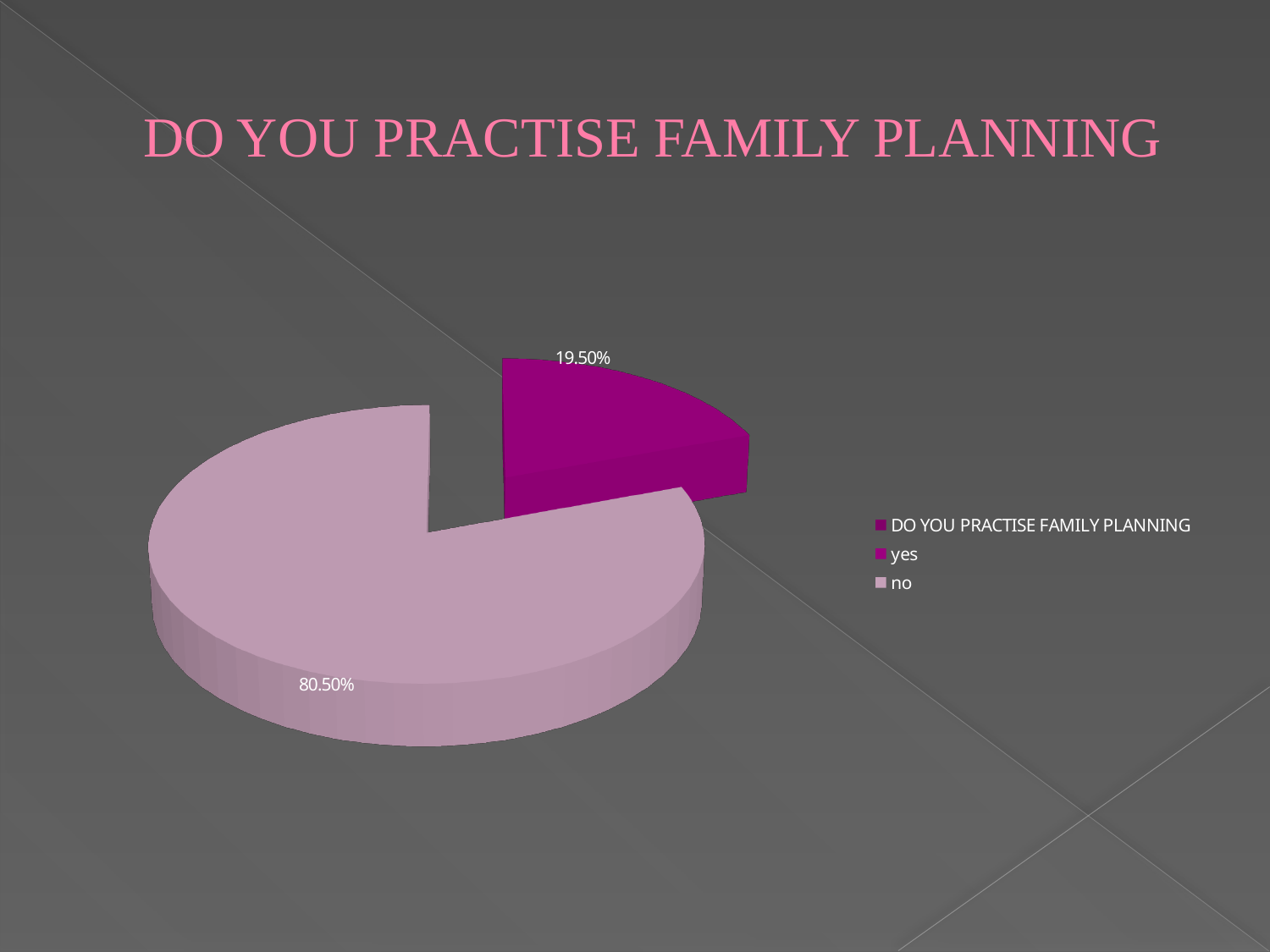
What is the value shown on the smaller slice of the pie? 19.50% What is the title of the chart? DO YOU PRACTISE FAMILY PLANNING What is the value shown on the larger slice of the pie? 80.50% How many entries does the legend list? 3 What is the largest value labelled on the pie chart? 80.50% What kind of chart is shown on the slide? pie chart Which slice is larger, the one labelled 19.50% or the one labelled 80.50%? 80.50% Is the value of the smaller slice greater or less than 20%? less What is the difference between the two labelled slice values? 61.00% How many slices are visible in the pie chart? 2 What do the two labelled slice values add up to? 100.00% What is the smallest value labelled on the pie chart? 19.50%